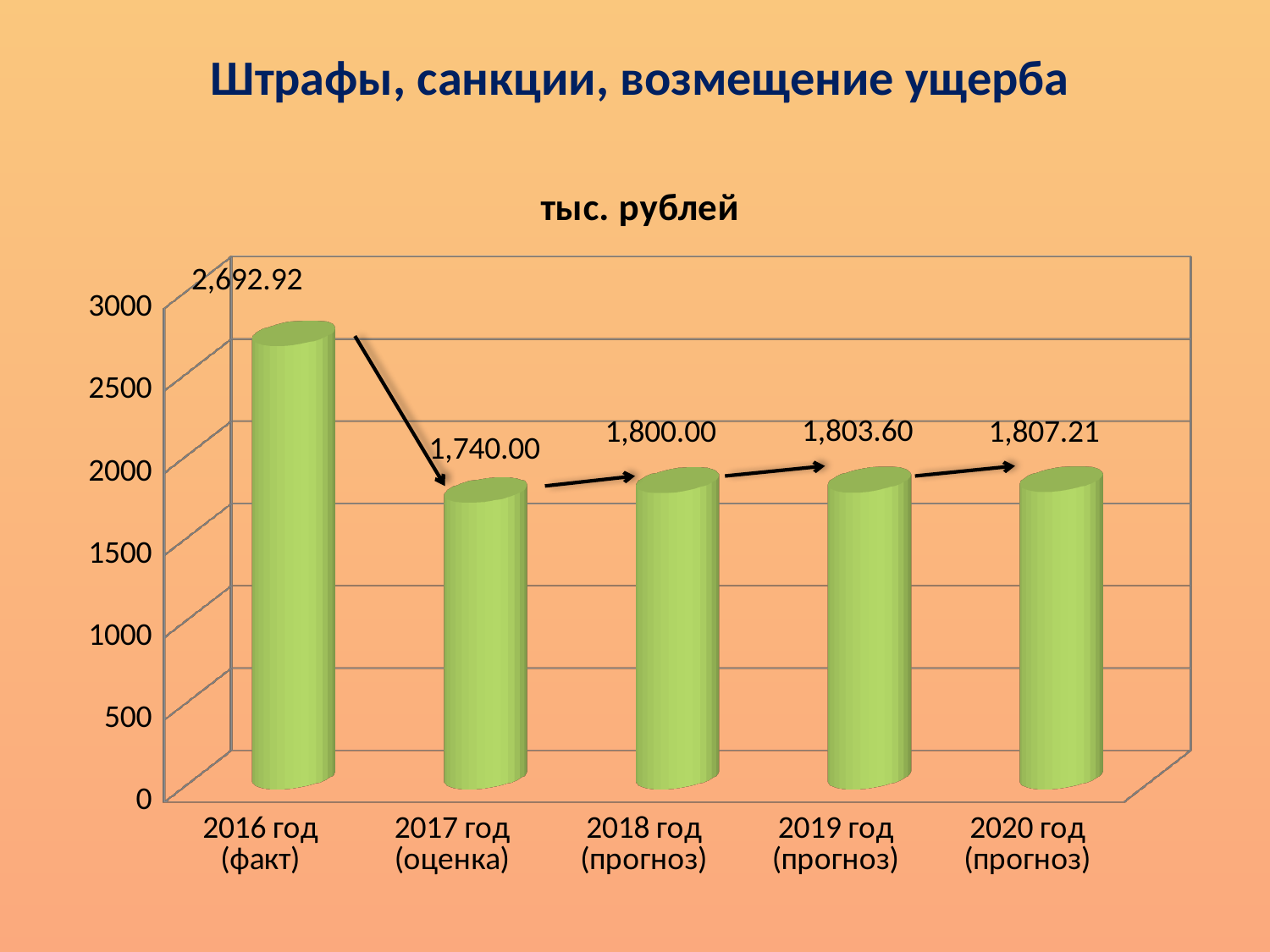
Which year has the highest value? 2016 год (факт) What is the value for 2017 год (оценка)? 1,740.00 What is the value for 2020 год (прогноз)? 1,807.21 Is the value for 2017 год (оценка) greater or less than 2000? less Which is larger, the value for 2016 год (факт) or 2018 год (прогноз)? 2016 год (факт) What is the difference between the values for 2020 год (прогноз) and 2018 год (прогноз)? 7.21 What is the value for 2019 год (прогноз)? 1,803.60 What is the difference between the values for 2016 год (факт) and 2017 год (оценка)? 952.92 Which year has the lowest value? 2017 год (оценка) What is the title of the chart? тыс. рублей What is the value for 2016 год (факт)? 2,692.92 How many years are shown on the x axis? 5